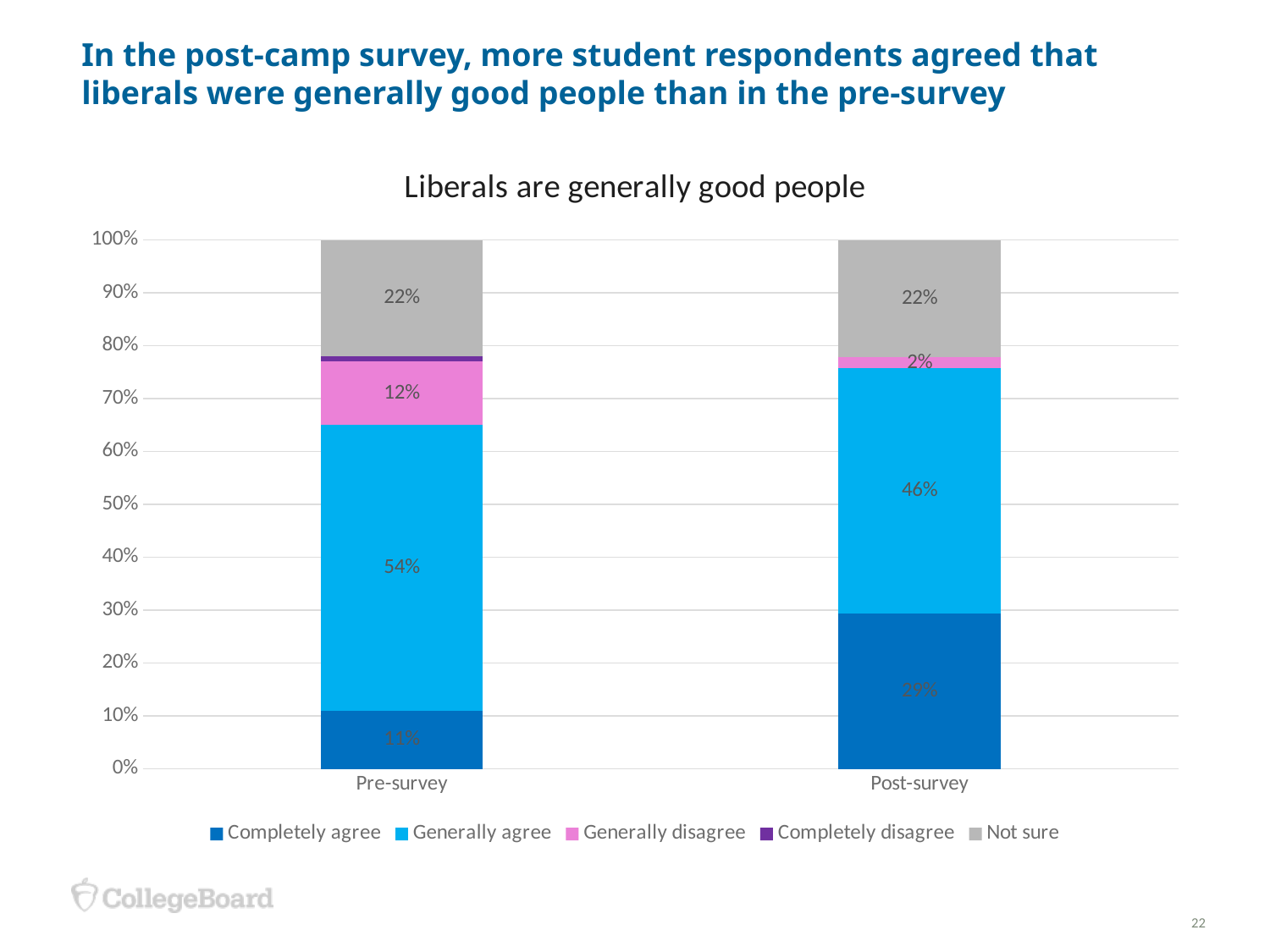
What percentage of Post-survey respondents chose 'Generally agree'? 46% What type of chart is shown on the slide? stacked bar chart How many series does the legend list? 5 What is the 'Generally disagree' value for the Post-survey bar? 2% What percentage of Pre-survey respondents chose 'Generally agree'? 54% What is the difference between the 'Generally disagree' values for Pre-survey and Post-survey? 10% Is the 'Completely agree' value for Post-survey greater or less than 20%? greater What is the 'Not sure' value for the Post-survey bar? 22% What is the title of the chart? Liberals are generally good people What is the 'Generally disagree' value for the Pre-survey bar? 12% How many categories are shown on the x axis? 2 Which survey has the larger 'Completely agree' share, Pre-survey or Post-survey? Post-survey